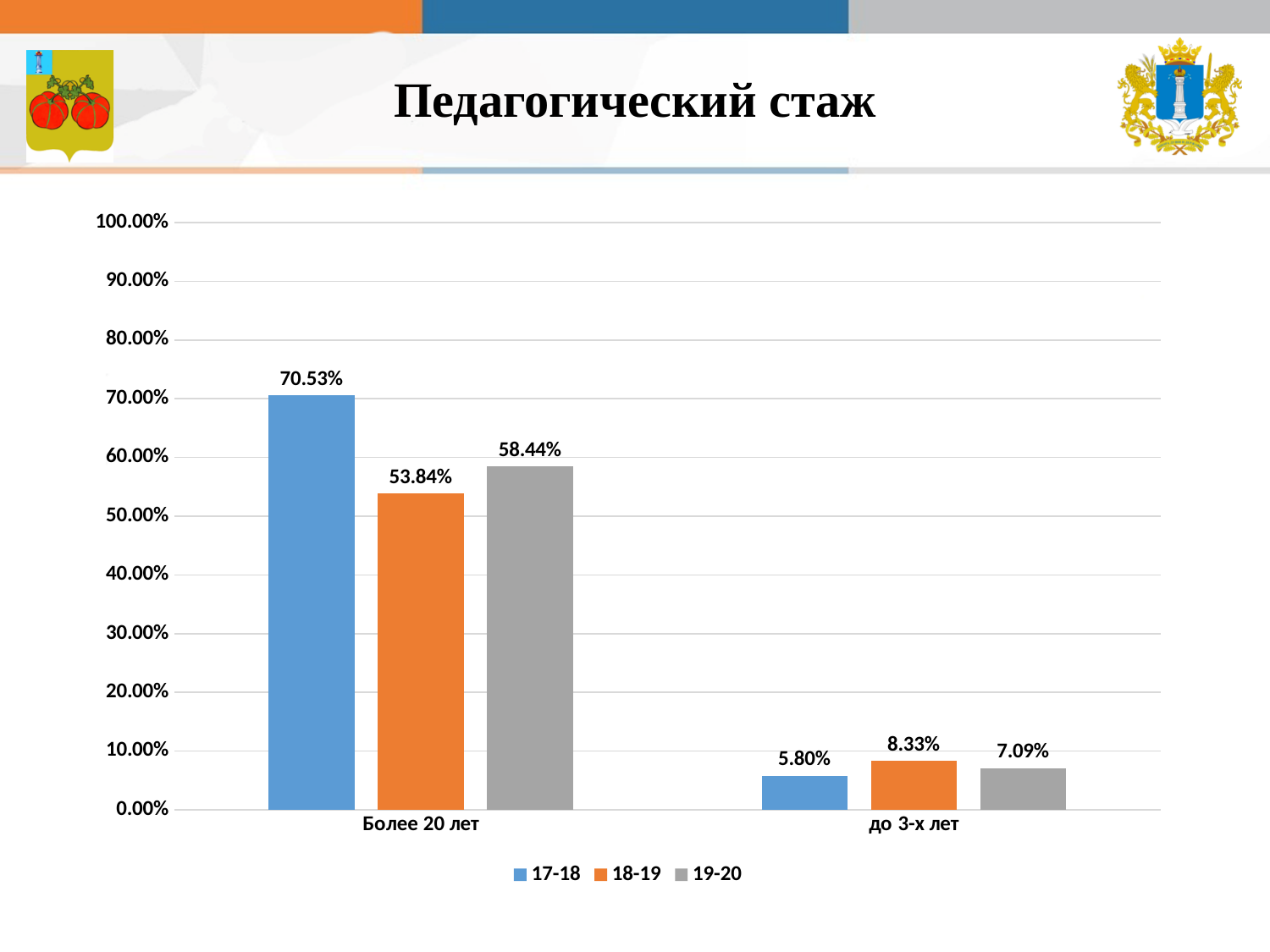
What is the value for 18-19 in the 'до 3-х лет' category? 8.33% How many series does the legend list? 3 Is the value for 19-20 in the 'до 3-х лет' category greater or less than 10.00%? less Which series has the lowest value in the 'до 3-х лет' category? 17-18 What is the value for 19-20 in the 'Более 20 лет' category? 58.44% What is the difference between the 17-18 and 18-19 values in the 'Более 20 лет' category? 16.69% What kind of chart is shown on the slide? bar chart What is the difference between the 18-19 and 19-20 values in the 'до 3-х лет' category? 1.24% How many categories are shown on the x axis? 2 Which is larger in the 'Более 20 лет' category: the 18-19 value or the 19-20 value? 19-20 Which series has the highest value in the 'Более 20 лет' category? 17-18 What is the value for 17-18 in the 'Более 20 лет' category? 70.53%